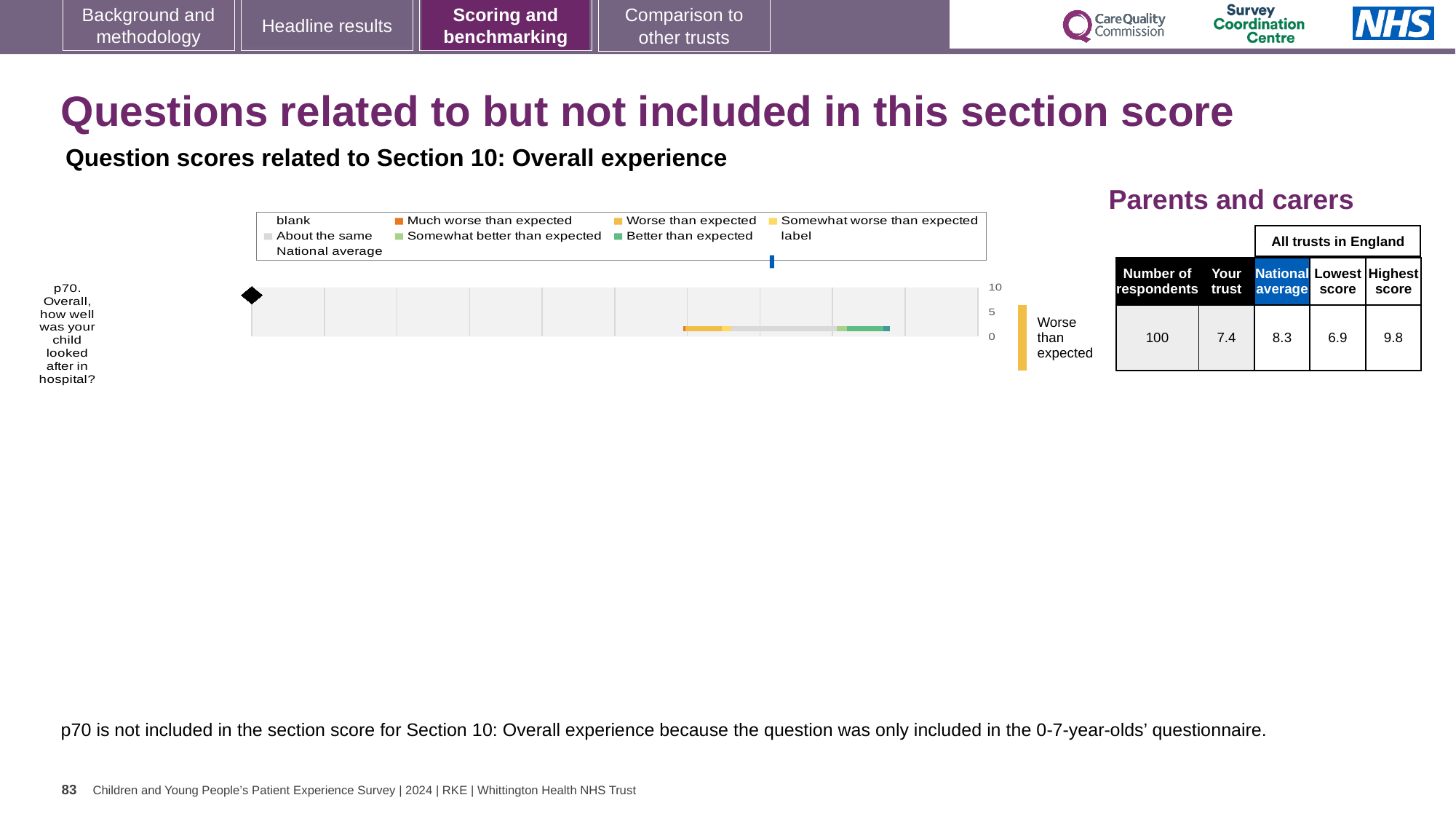
Which question is plotted on the chart? p70. Overall, how well was your child looked after in hospital? What category label is shown to the right of the chart for p70? Worse than expected According to the table next to the chart, what is the 'Your trust' score for p70? 7.4 How many survey questions are plotted on the chart? 1 What is the difference between the highest and lowest scores among all trusts in England for p70? 2.9 According to the table next to the chart, what is the national average score for p70? 8.3 What kind of chart is used to show the p70 question score? bar chart According to the table next to the chart, what is the lowest score among all trusts in England for p70? 6.9 According to the table next to the chart, what is the highest score among all trusts in England for p70? 9.8 How many respondents answered p70 according to the table next to the chart? 100 What is the difference between the national average and the 'Your trust' score for p70? 0.9 Is the 'Your trust' score for p70 larger or smaller than the national average? smaller